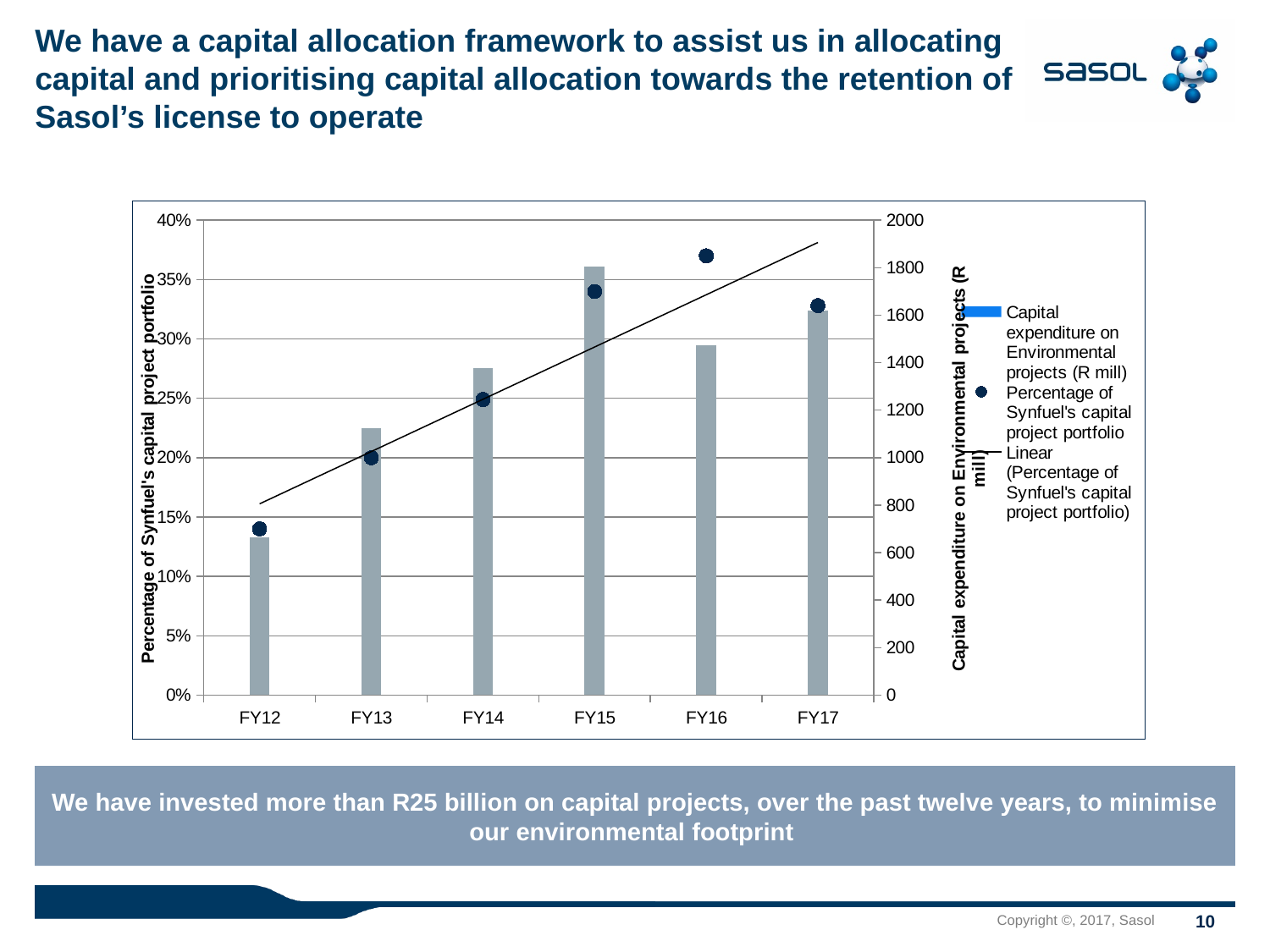
Which fiscal year has the highest percentage of Synfuel's capital project portfolio? FY16 What kind of chart is shown on the slide? A combination bar and scatter chart with a linear trendline Is the capital expenditure on environmental projects for FY12 greater or less than 800? less How many fiscal years are shown on the x axis of the chart? 6 Which fiscal year has the lowest bar for capital expenditure on environmental projects? FY12 Is the capital expenditure on environmental projects for FY15 greater or less than 1600? greater Which fiscal year has the highest bar for capital expenditure on environmental projects? FY15 How many series does the chart legend list? 3 Which fiscal year has the lowest percentage of Synfuel's capital project portfolio? FY12 Which has the larger capital expenditure on environmental projects, FY15 or FY16? FY15 Is the percentage of Synfuel's capital project portfolio for FY16 greater or less than 35%? greater Does the linear trendline for the percentage of Synfuel's capital project portfolio rise or fall from FY12 to FY17? rise